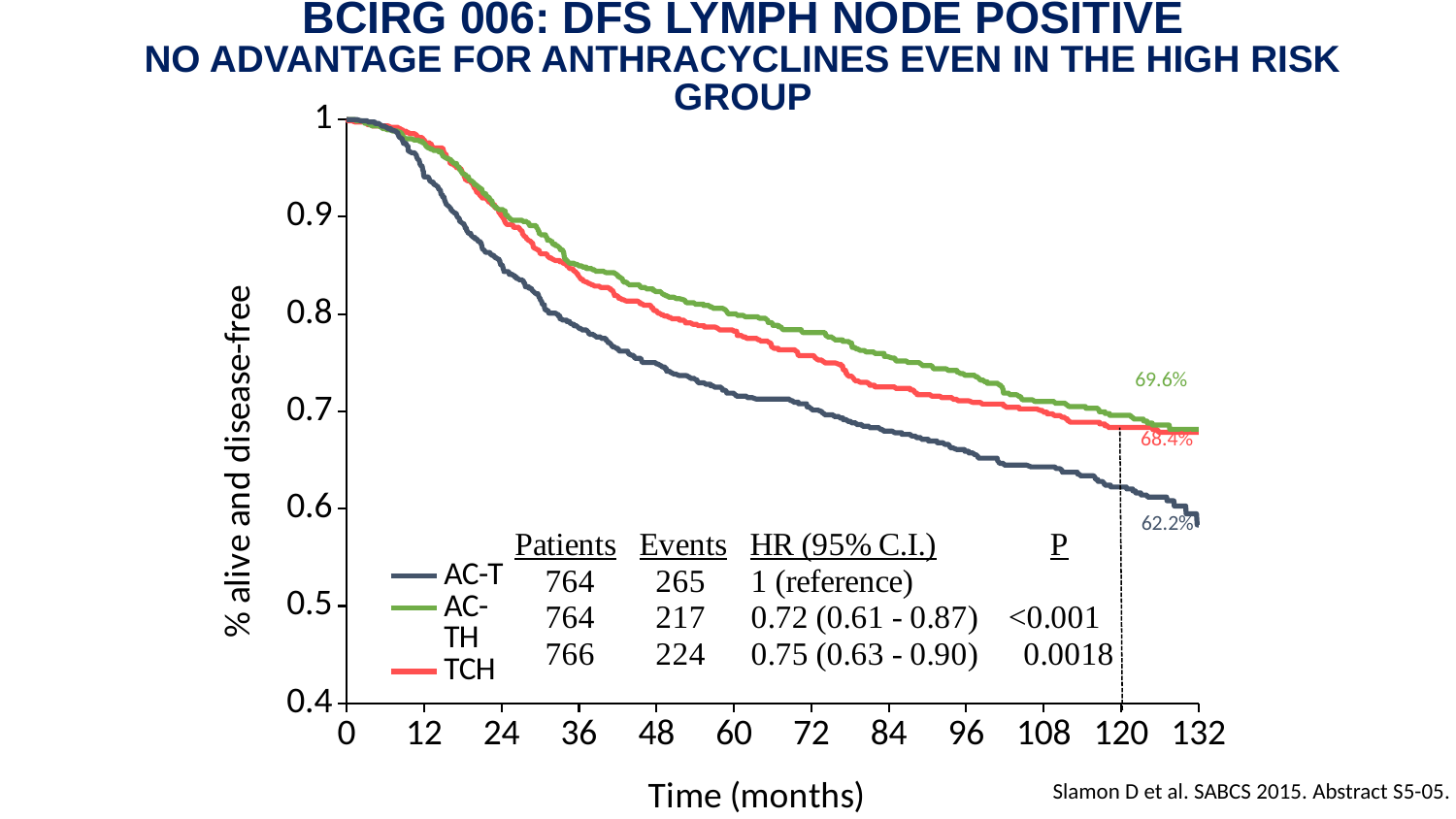
What is the labelled disease-free survival rate for the AC-T arm at 120 months? 62.2% Which treatment arm has the highest labelled disease-free survival rate at 120 months? AC-TH Do the curves rise or fall as time in months increases? Fall What is the labelled disease-free survival rate for the AC-TH arm at 120 months? 69.6% Is the value for the AC-T curve at 60 months greater or less than 0.8? less How many treatment arms (series) does the legend list? 3 How many events are listed for the AC-T arm in the table? 265 What is the label on the x axis of the chart? Time (months) What is the labelled disease-free survival rate for the TCH arm at 120 months? 68.4% Which treatment arm has the lowest labelled disease-free survival rate at 120 months? AC-T What is the difference in percentage points between the AC-TH and AC-T labelled rates at 120 months? 7.4 percentage points What kind of chart is shown on the slide? Line chart